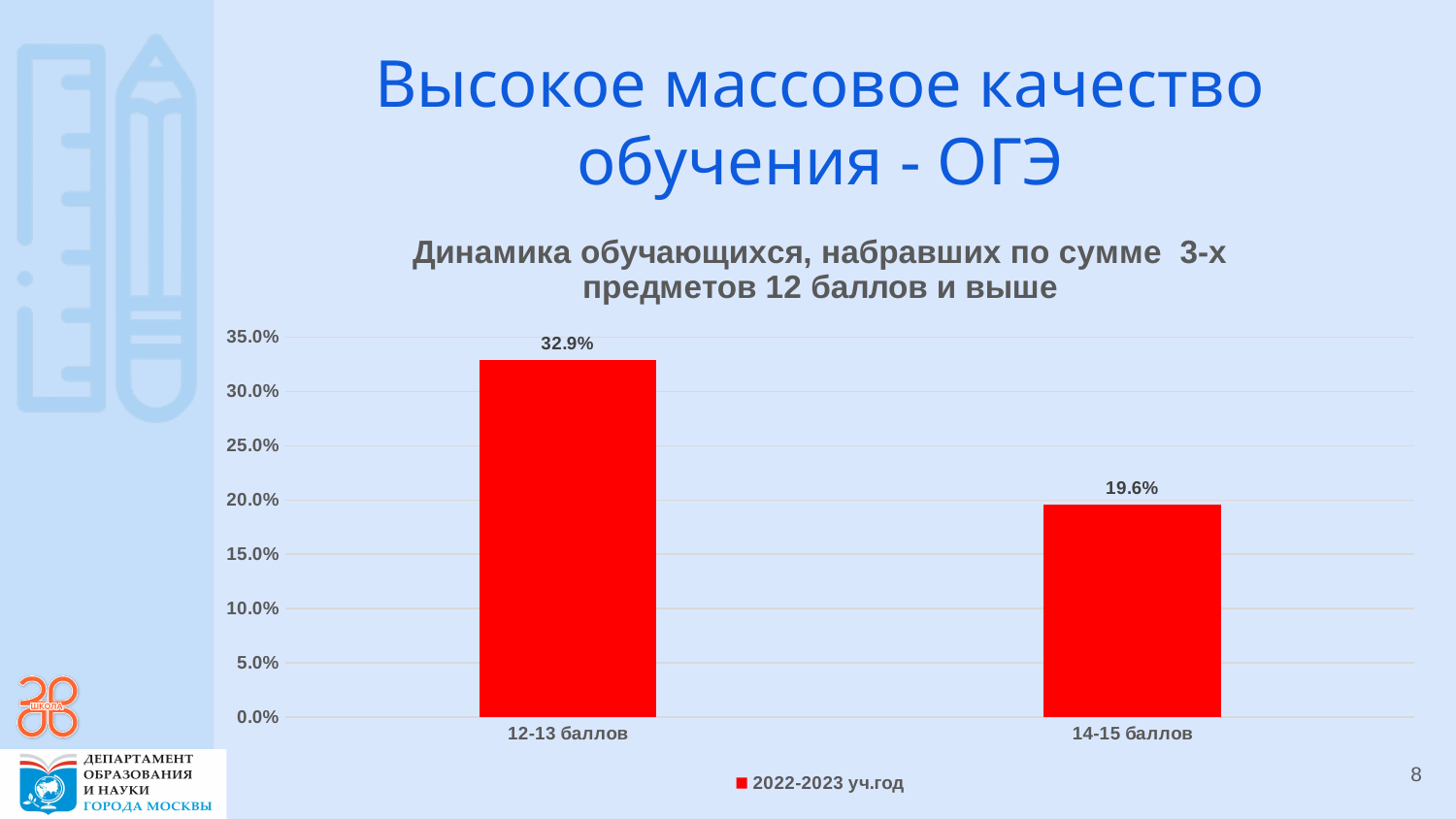
What is the value for the "12-13 баллов" category? 32.9% Which is larger: the value for "12-13 баллов" or for "14-15 баллов"? 12-13 баллов What is the value for the "14-15 баллов" category? 19.6% Which category has the lowest value? 14-15 баллов What kind of chart is shown on the slide? bar chart Is the value for "14-15 баллов" greater or less than 20.0%? less What series name is shown in the legend? 2022-2023 уч.год Which category has the highest value? 12-13 баллов How many categories are shown on the x axis? 2 What is the difference between the values for "12-13 баллов" and "14-15 баллов"? 13.3% Is the value for "12-13 баллов" greater or less than 30.0%? greater How many series does the legend list? 1